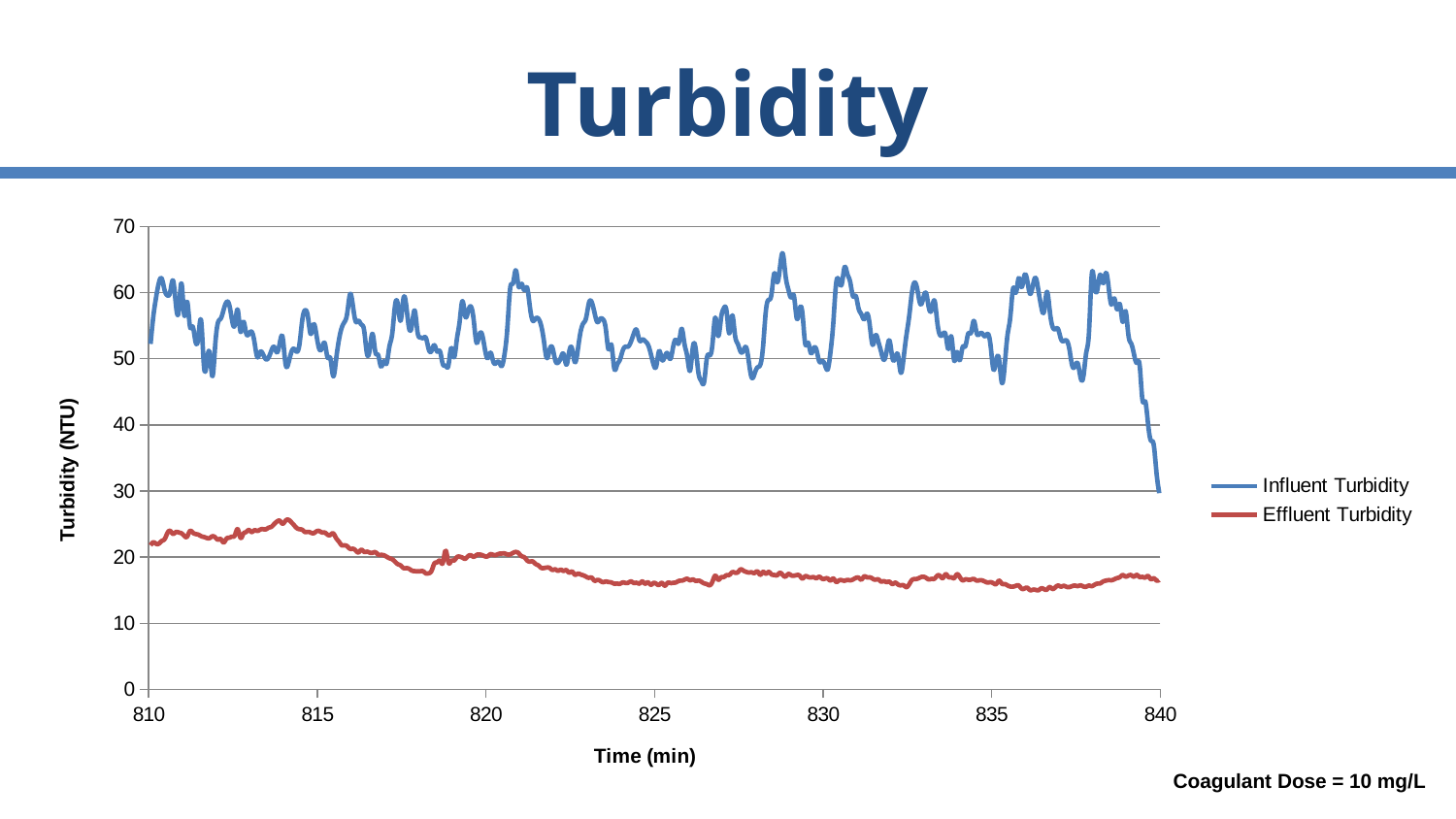
How many series does the legend list? 2 What is the label of the x axis? Time (min) Is the Influent Turbidity value at 840 min greater or less than 40? less What coagulant dose is noted on the slide? 10 mg/L Which series has higher values throughout the chart, Influent Turbidity or Effluent Turbidity? Influent Turbidity Is the Effluent Turbidity value at 815 min greater or less than 30? less Is the Influent Turbidity value at 825 min greater or less than 40? greater Does the Effluent Turbidity line generally rise or fall from 810 min to 840 min? fall What kind of chart is shown on the slide? Line chart